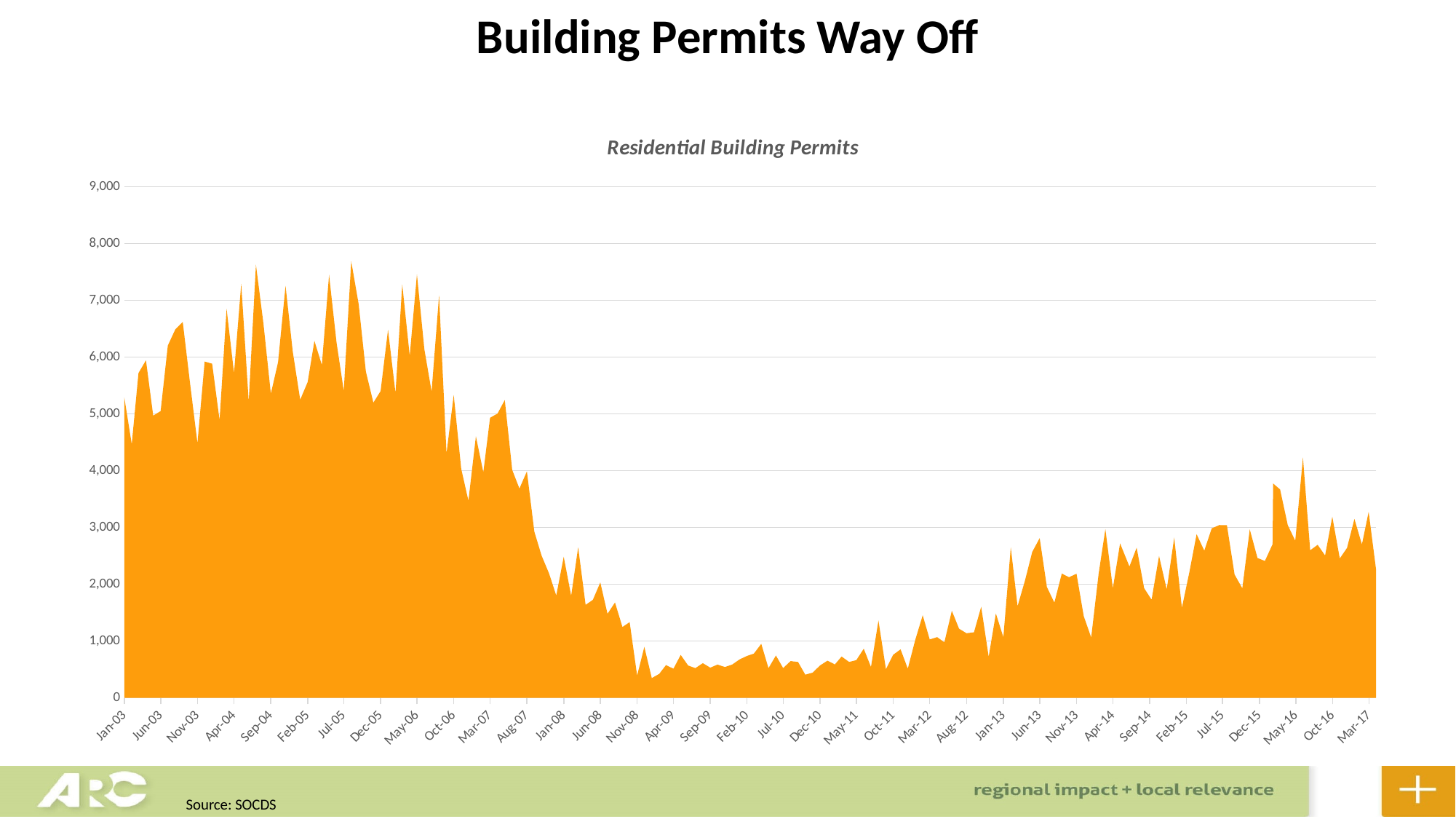
Do the values generally rise or fall between Jan-03 and Nov-08? fall Do the values generally rise or fall between Nov-08 and Mar-17? rise What type of chart is shown on the slide? Area chart Is the value for Mar-17 greater or less than 1,000? greater What is the title of the chart? Residential Building Permits Is the value for Apr-09 greater or less than 1,000? less Which is larger, the value for Jul-05 or the value for Apr-09? Jul-05 Is the value for Jul-10 greater or less than 1,000? less What is the highest value shown on the vertical axis? 9,000